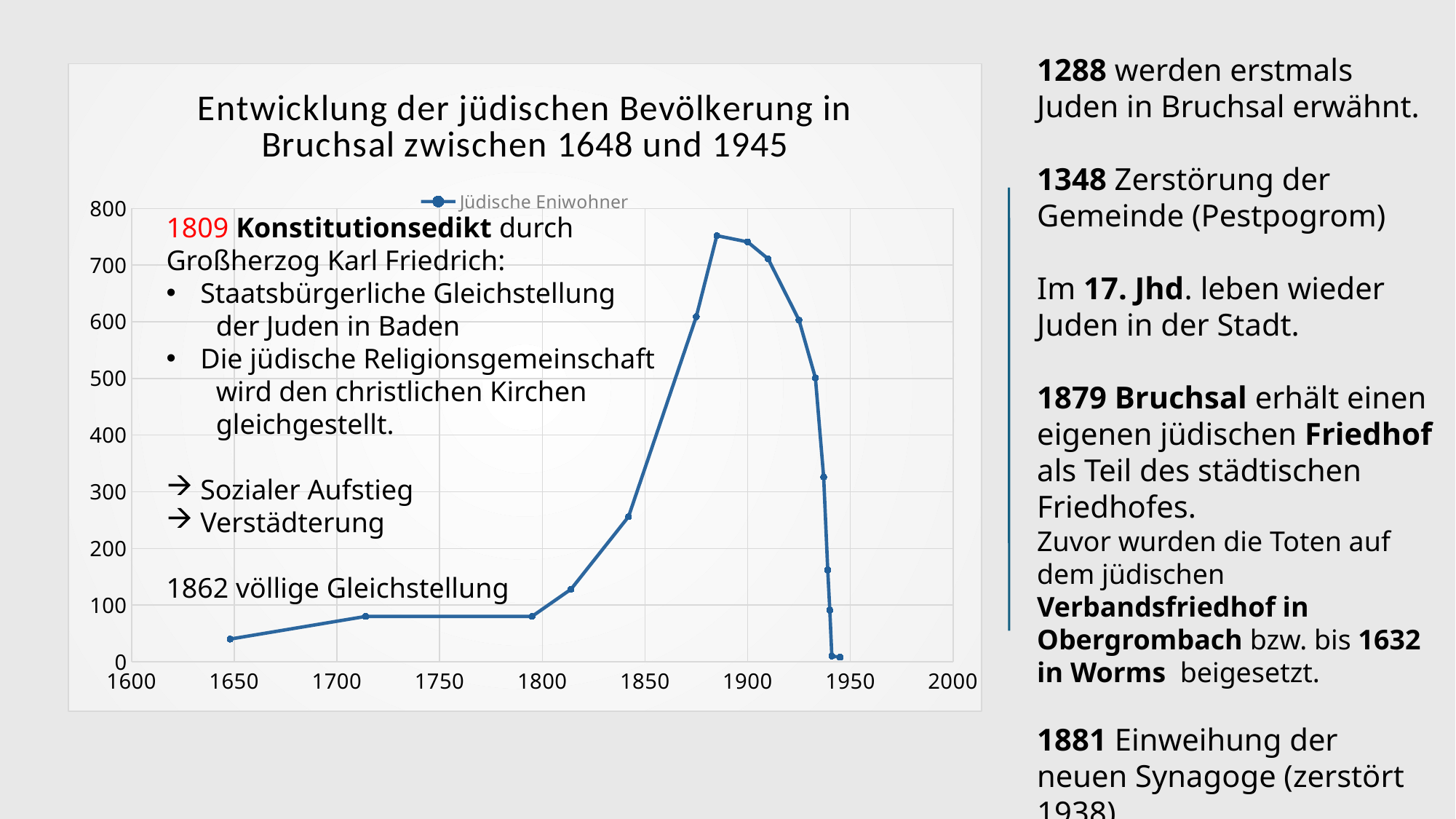
Is the value for the data point around 1842 greater or less than 200? greater What is the title of the chart? Entwicklung der jüdischen Bevölkerung in Bruchsal zwischen 1648 und 1945 Is the highest value on the chart (around 1885) greater or less than 700? greater What kind of chart is shown on the slide? line chart How many series does the chart's legend list? 1 Which is larger: the value around 1650 or the value around 1885? around 1885 Does the line rise or fall between 1650 and 1885? rise Is the value for the first data point (around 1650) greater or less than 100? less What is the name of the series shown in the legend? Jüdische Eniwohner